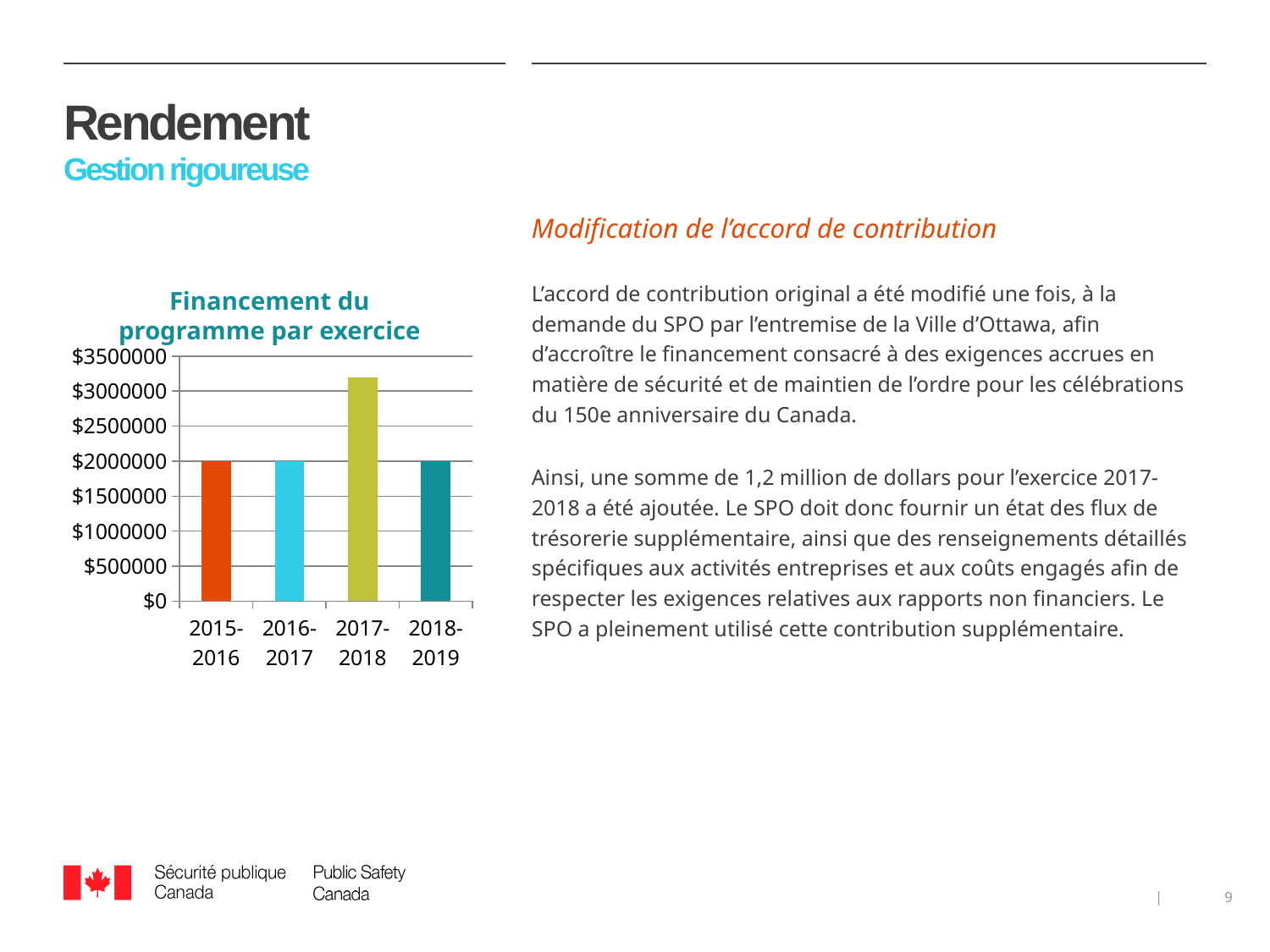
What is the funding value for 2015-2016 in the chart? $2000000 What is the funding value for 2016-2017 in the chart? $2000000 Which fiscal year has the highest funding in the chart? 2017-2018 Is the funding value for 2015-2016 greater or less than $2500000? less Is the funding value for 2017-2018 greater or less than $3000000? greater Which is larger in the chart, the funding for 2017-2018 or for 2016-2017? 2017-2018 What kind of chart is shown on the slide? bar chart What is the funding value for 2018-2019 in the chart? $2000000 How many fiscal years (categories) are shown on the x axis of the chart? 4 What is the title of the chart? Financement du programme par exercice Is the funding value for 2017-2018 greater or less than $3500000? less What is the highest value shown on the y axis of the chart? $3500000